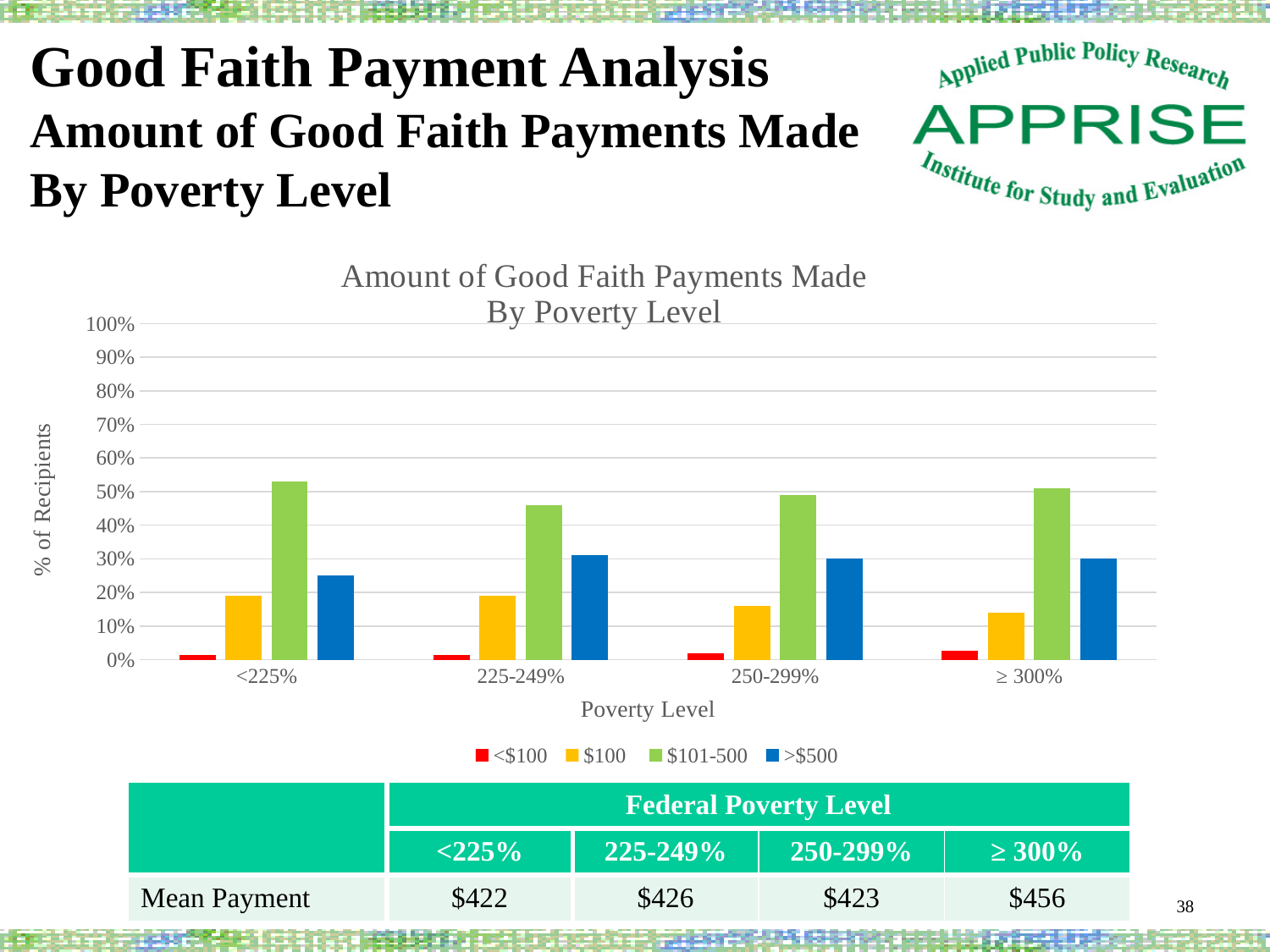
Which is larger for the >$500 series: the value at <225% or at 225-249%? 225-249% What is the label on the vertical axis of the chart? % of Recipients Is the value for $101-500 at the 225-249% poverty level greater or less than 40%? greater For the <225% poverty level, which payment amount series has the highest bar? $101-500 Is the value for $101-500 at the <225% poverty level greater or less than 50%? greater For the ≥ 300% poverty level, which payment amount series has the lowest bar? <$100 Is the value for >$500 at the <225% poverty level greater or less than 30%? less How many poverty level categories are shown on the x axis? 4 How many series does the legend list? 4 What kind of chart is shown on the slide? bar chart Which is larger for the $101-500 series: the value at <225% or at 225-249%? <225%